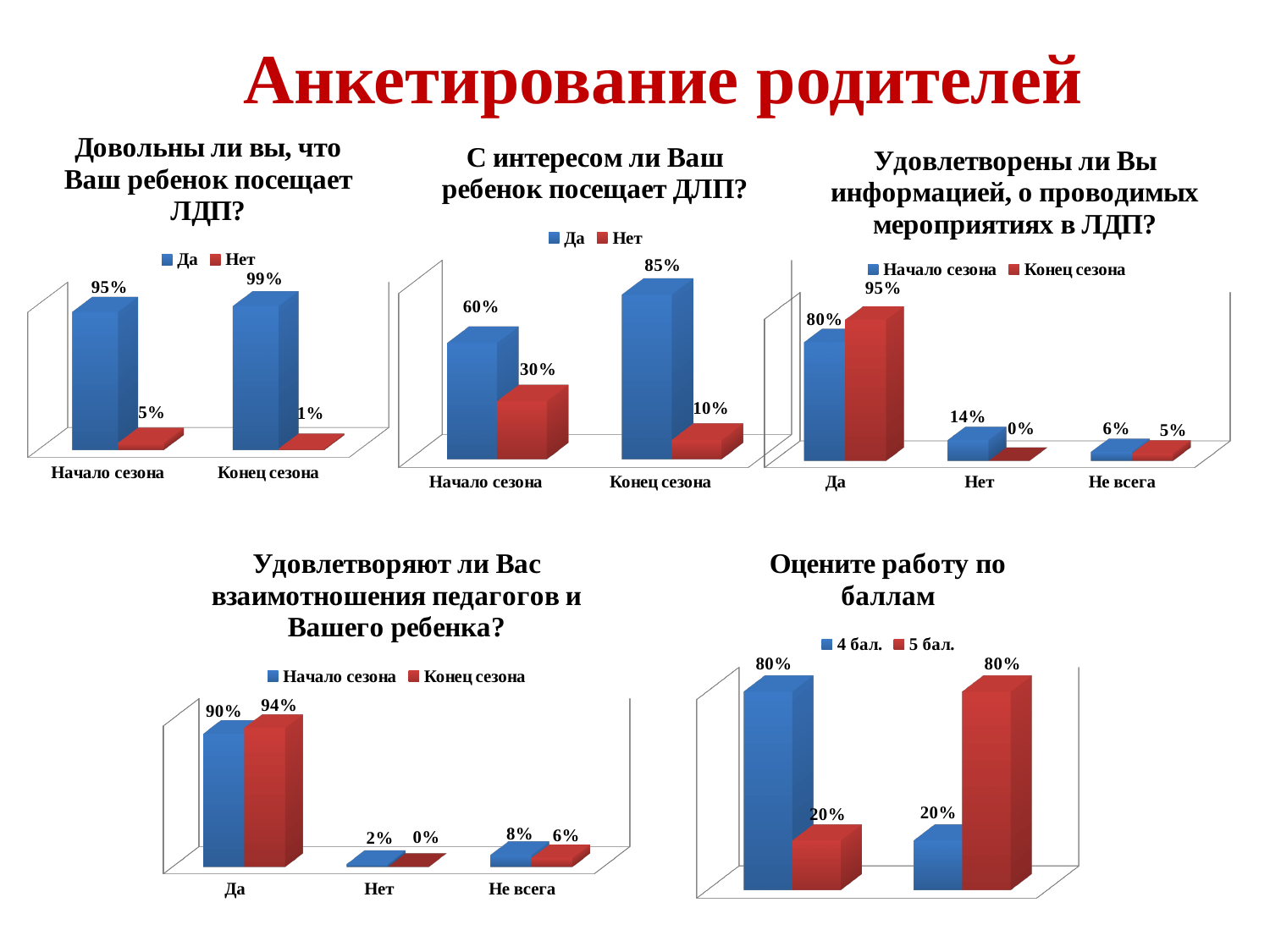
In the chart titled "Оцените работу по баллам", how many series does the legend list? 2 In the chart titled "Удовлетворяют ли Вас взаимотношения педагогов и Вашего ребенка?", what is the "Начало сезона" value for "Не всега"? 8% In the chart titled "Довольны ли вы, что Ваш ребенок посещает ЛДП?", what is the value for "Да" at "Конец сезона"? 99% What kind of chart is the one titled "Оцените работу по баллам"? bar chart In the chart titled "С интересом ли Ваш ребенок посещает ДЛП?", does the "Да" value rise or fall from "Начало сезона" to "Конец сезона"? rise In the chart titled "Удовлетворены ли Вы информацией, о проводимых мероприятиях в ЛДП?", what is the "Конец сезона" value for "Да"? 95% In the chart titled "С интересом ли Ваш ребенок посещает ДЛП?", what is the value for "Нет" at "Начало сезона"? 30% In the chart titled "Довольны ли вы, что Ваш ребенок посещает ЛДП?", what is the difference between the "Да" values at "Конец сезона" and "Начало сезона"? 4% In the chart titled "Удовлетворяют ли Вас взаимотношения педагогов и Вашего ребенка?", which is larger for "Да": "Начало сезона" or "Конец сезона"? Конец сезона In the chart titled "Удовлетворены ли Вы информацией, о проводимых мероприятиях в ЛДП?", which category has the lowest "Начало сезона" value? Не всега In the chart titled "Удовлетворены ли Вы информацией, о проводимых мероприятиях в ЛДП?", how many categories are shown on the x axis? 3 In the chart titled "Удовлетворяют ли Вас взаимотношения педагогов и Вашего ребенка?", what is the difference between the "Начало сезона" and "Конец сезона" values for "Нет"? 2%